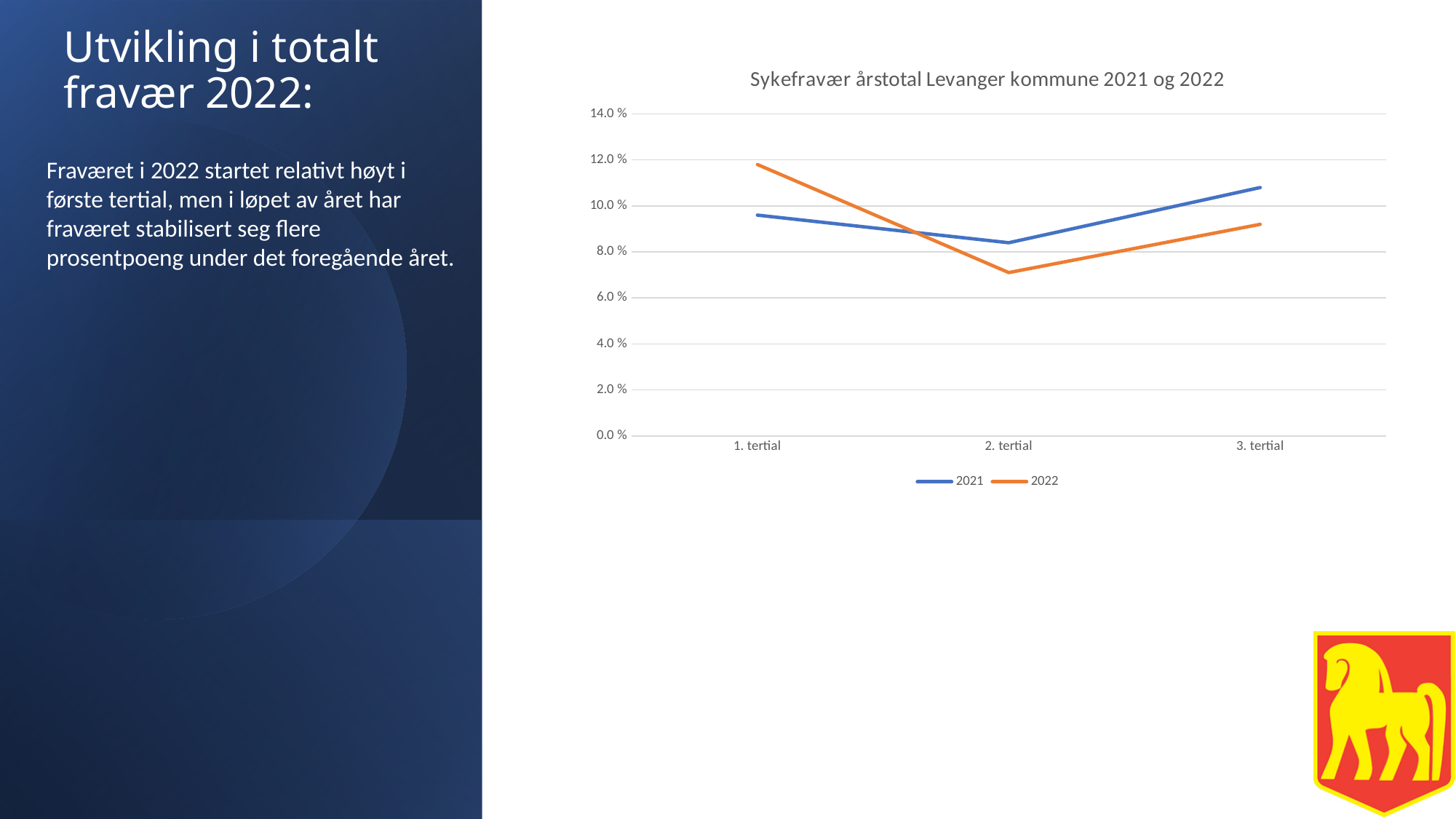
At 3. tertial, which series has the larger value, 2021 or 2022? 2021 Which tertial has the lowest value for the 2022 series? 2. tertial Which tertial has the highest value for the 2021 series? 3. tertial How many categories are shown on the x axis? 3 What is the title of the chart? Sykefravær årstotal Levanger kommune 2021 og 2022 How many series does the legend list? 2 What kind of chart is shown on the slide? line chart Which tertial has the highest value for the 2022 series? 1. tertial At 1. tertial, which series has the larger value, 2021 or 2022? 2022 Is the value for 2022 at 1. tertial greater or less than 10.0 %? greater Does the 2022 series rise or fall from 1. tertial to 2. tertial? fall Is the value for 2022 at 2. tertial greater or less than 8.0 %? less